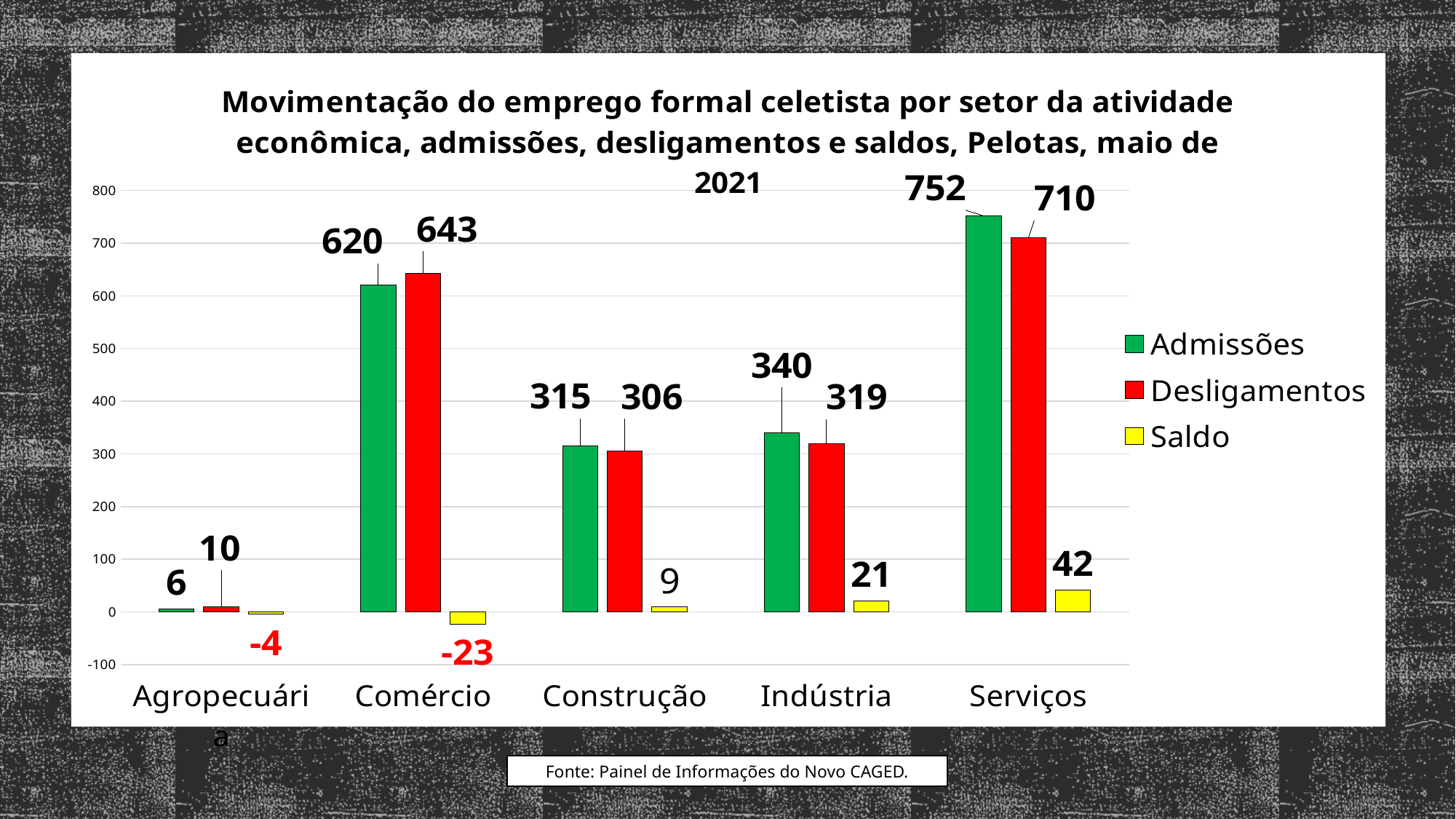
What kind of chart is shown on the slide? Bar chart How many sectors are shown on the x axis? 5 How many series does the legend list? 3 What is the Saldo value for Comércio? -23 What is the Saldo value for Indústria? 21 Which is larger for Indústria, Admissões or Desligamentos? Admissões What is the Admissões value for Comércio? 620 Which sector has the highest Admissões value? Serviços What is the Desligamentos value for Serviços? 710 What is the difference between Desligamentos and Admissões for Comércio? 23 Which sector has the lowest Desligamentos value? Agropecuária Is the Admissões value for Serviços greater or less than 700? greater